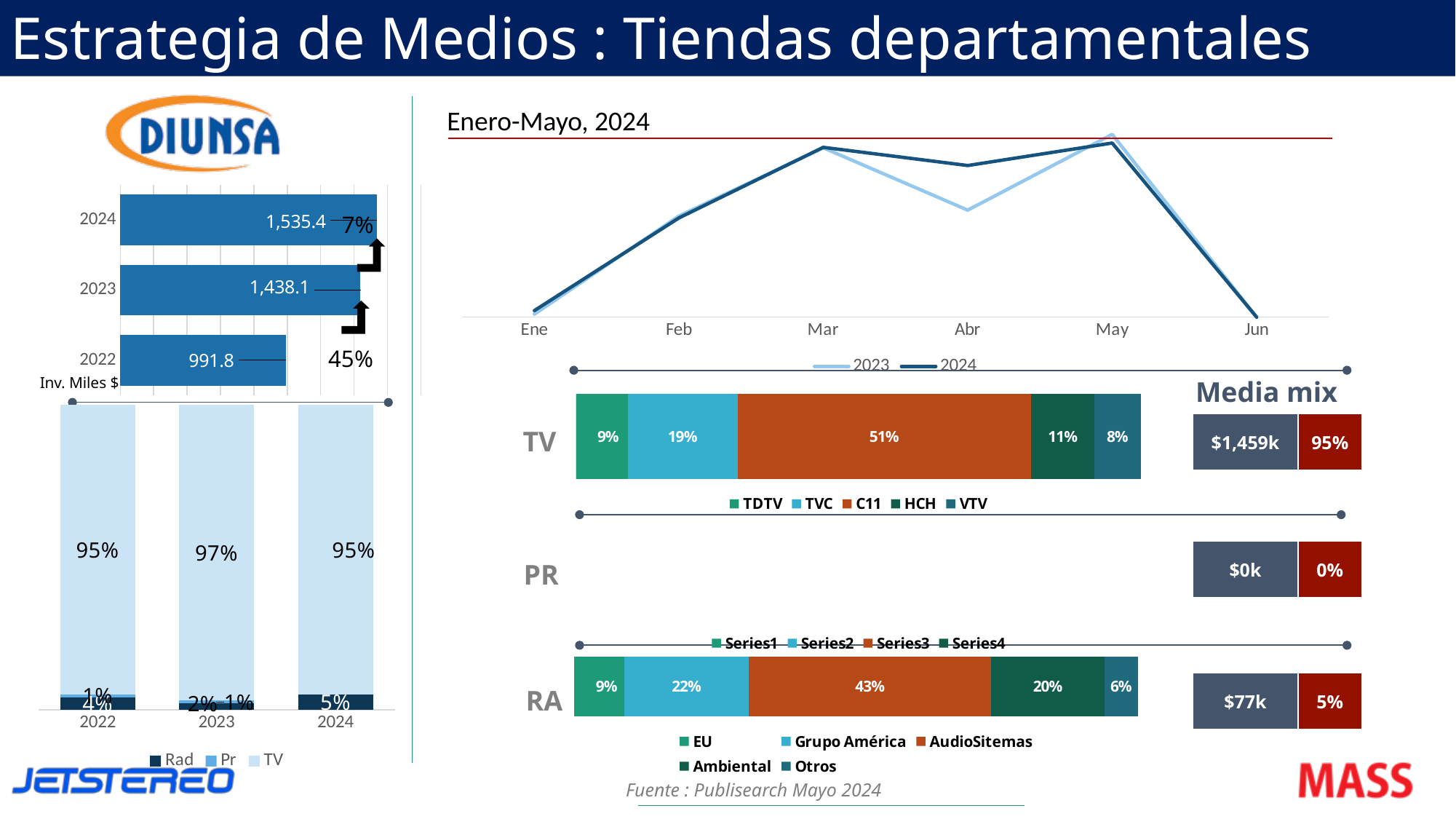
What kind of chart is the Enero-Mayo, 2024 chart at the top right? line chart In the Media mix boxes, what is the amount shown for RA? $77k In the horizontal bar chart of investment (Inv. Miles $) on the left, how many years are shown? 3 In the horizontal bar chart of investment (Inv. Miles $) on the left, which year has the lowest value? 2022 In the line chart titled Enero-Mayo, 2024, how many series does the legend list? 2 In the stacked bar chart at the bottom left, how many series does the legend list? 3 In the RA stacked bar on the right, which category has the highest share? AudioSitemas In the horizontal bar chart of investment (Inv. Miles $) on the left, what is the value for 2022? 991.8 In the horizontal bar chart of investment (Inv. Miles $) on the left, what is the value for 2024? 1,535.4 In the stacked bar chart at the bottom left, what is the TV share for 2023? 97% In the TV stacked bar on the right, what is the share for C11? 51% In the horizontal bar chart of investment (Inv. Miles $) on the left, what is the difference between the 2024 and 2023 values? 97.3